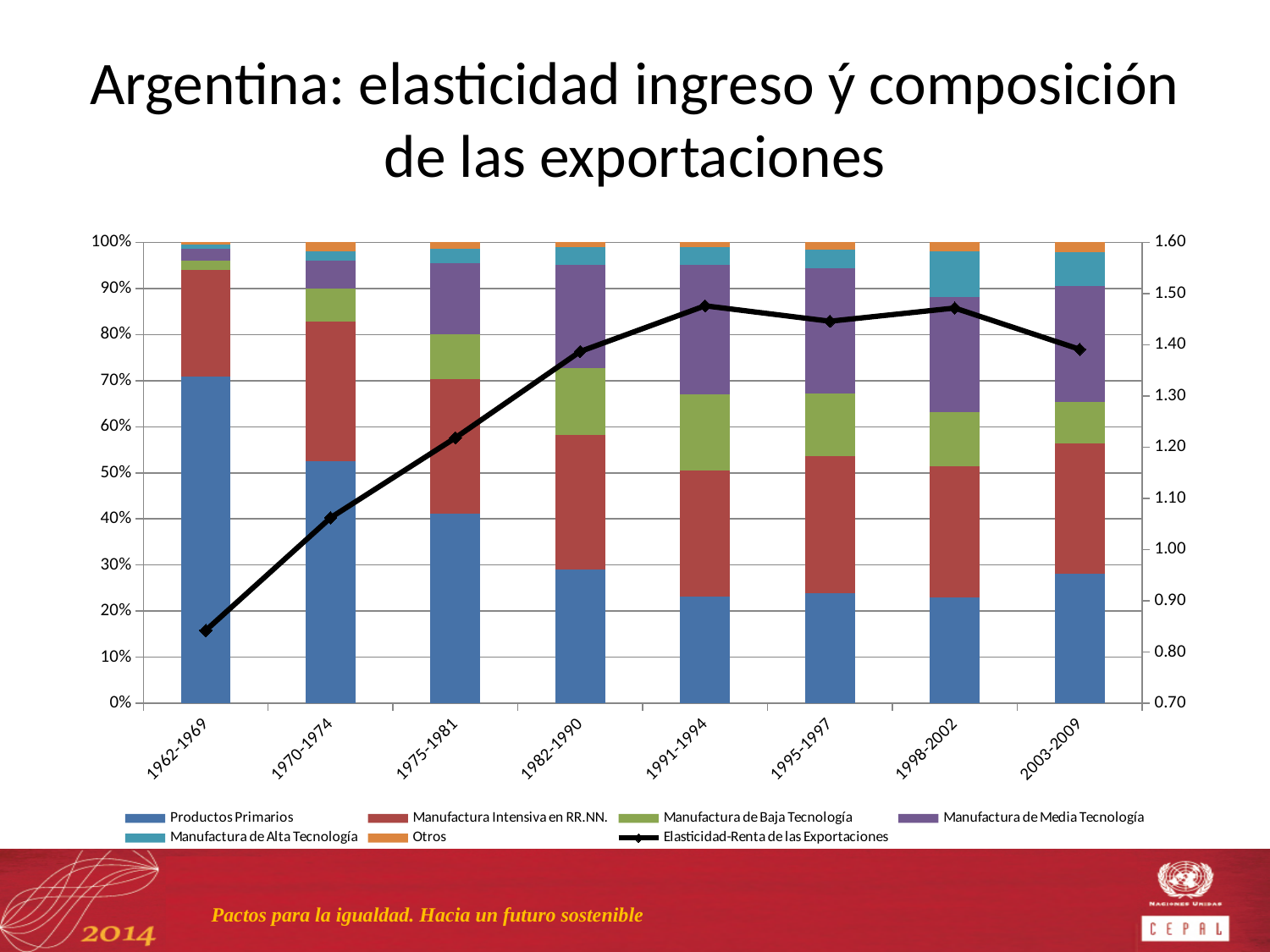
Does the Elasticidad-Renta de las Exportaciones line rise or fall from 1962-1969 to 1991-1994? rise How many time periods are shown on the x axis? 8 Which period has the highest share of Productos Primarios? 1962-1969 How many series does the legend list? 7 Is the Productos Primarios share for 2003-2009 greater or less than 40%? less What is the maximum value shown on the right-hand axis? 1.60 Is the Elasticidad-Renta de las Exportaciones value for 1962-1969 greater or less than 0.90? less What kind of chart is shown on the slide? Stacked bar chart with a line Is the Elasticidad-Renta de las Exportaciones value for 1991-1994 greater or less than 1.40? greater In which period is the Elasticidad-Renta de las Exportaciones line at its lowest? 1962-1969 Which is larger, the Productos Primarios share in 1962-1969 or in 1975-1981? 1962-1969